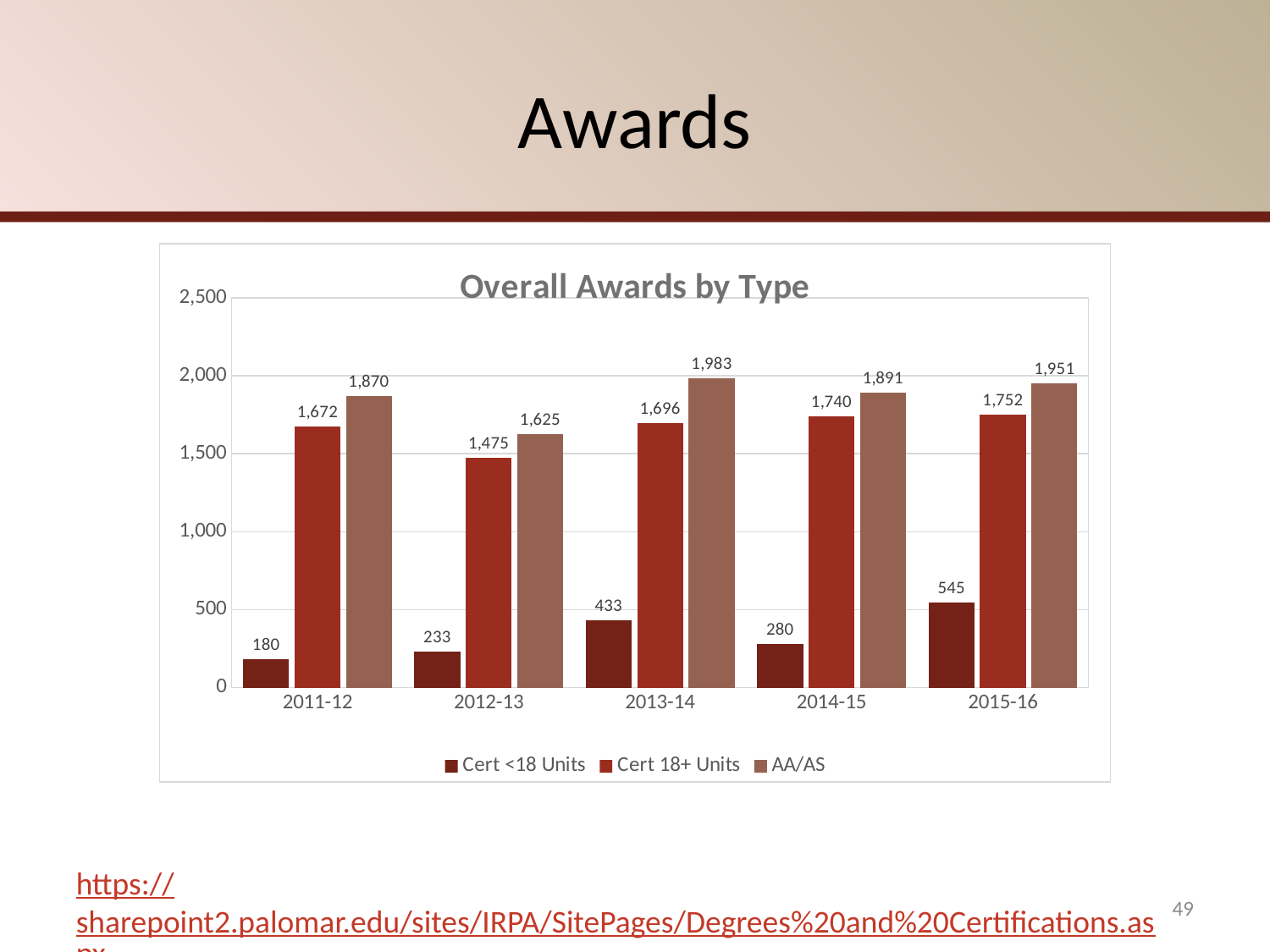
What is the value for Cert <18 Units in 2015-16? 545 Which is larger in 2014-15: Cert 18+ Units or AA/AS? AA/AS What kind of chart is shown? bar chart What is the difference between the AA/AS value and the Cert 18+ Units value in 2011-12? 198 Which year has the lowest value for Cert <18 Units? 2011-12 How many years are shown on the x axis? 5 What is the title of the chart? Overall Awards by Type How many series does the legend list? 3 What is the value for Cert 18+ Units in 2012-13? 1,475 Which year has the highest value for AA/AS? 2013-14 Does the Cert 18+ Units value rise or fall from 2012-13 to 2015-16? rise What is the value for AA/AS in 2013-14? 1,983